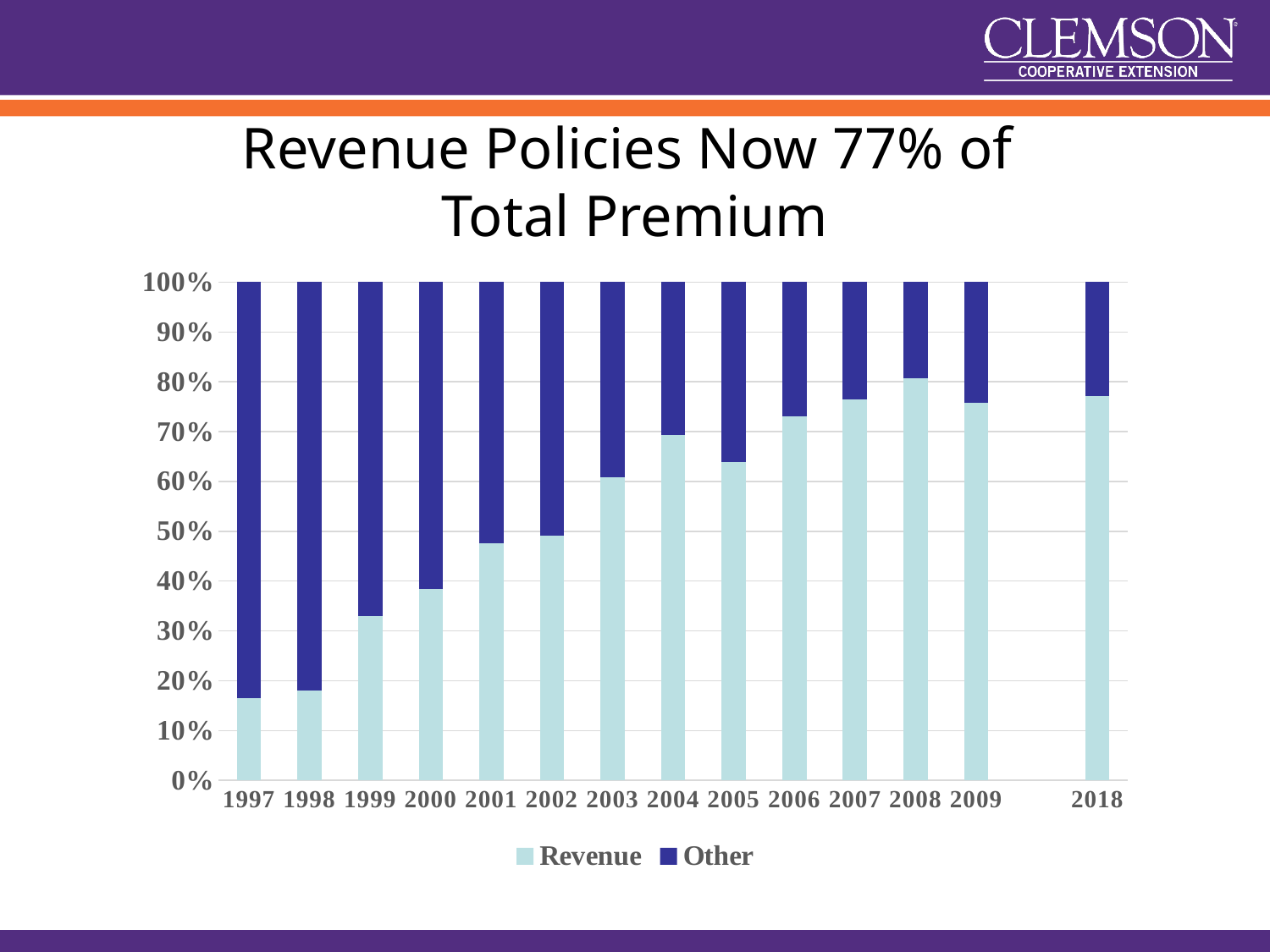
What kind of chart is shown on the slide? bar chart Which year has the highest Revenue share? 2008 Is the Revenue share for 2008 greater or less than 80%? greater Is the Revenue share for 2006 greater or less than 70%? greater How many years are shown on the x axis? 14 Is the Revenue share for 1997 greater or less than 20%? less What is the title of the chart? Revenue Policies Now 77% of Total Premium Which year has the larger Revenue share, 2004 or 2005? 2004 Does the Revenue share generally rise or fall from 1997 to 2008? rise How many series does the legend list? 2 Which year has the lowest Revenue share? 1997